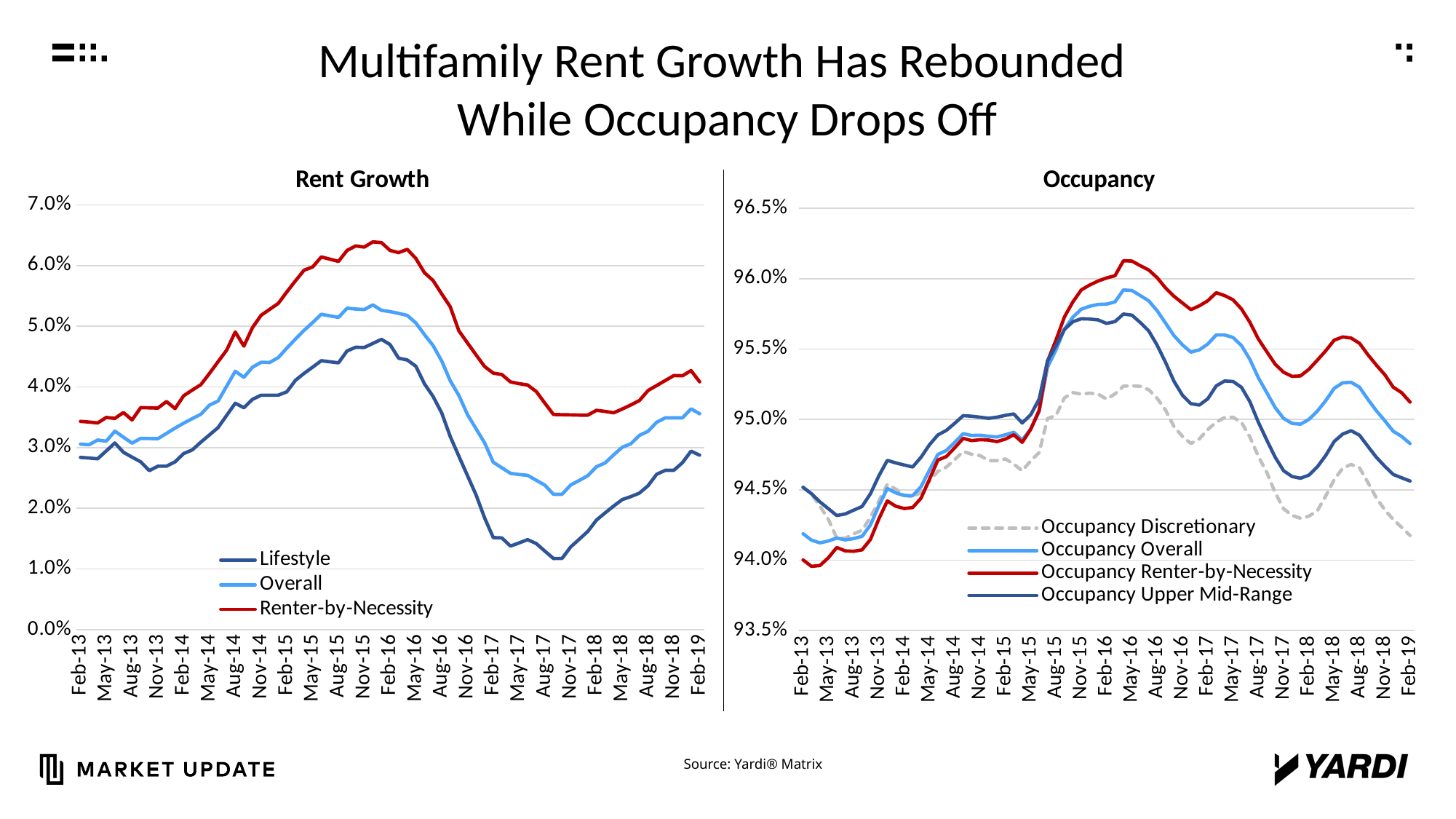
In the Rent Growth chart, which is larger at Feb-19: Renter-by-Necessity or Lifestyle? Renter-by-Necessity What kind of chart is the Rent Growth chart on the left? line chart In the Rent Growth chart, which series has the highest value at Feb-16? Renter-by-Necessity In the Occupancy chart, is the Occupancy Discretionary value at Feb-19 greater or less than 94.5%? less In the Occupancy chart, is the Occupancy Renter-by-Necessity value at May-16 greater or less than 95.5%? greater How many series does the legend of the Rent Growth chart list? 3 In the Rent Growth chart, is the Lifestyle value at Nov-17 greater or less than 2.0%? less In the Rent Growth chart, does the Overall series rise or fall between Feb-16 and Feb-17? fall How many series does the legend of the Occupancy chart list? 4 What is the title of the chart on the right side of the slide? Occupancy In the Occupancy chart, which series has the lowest value at Feb-19? Occupancy Discretionary